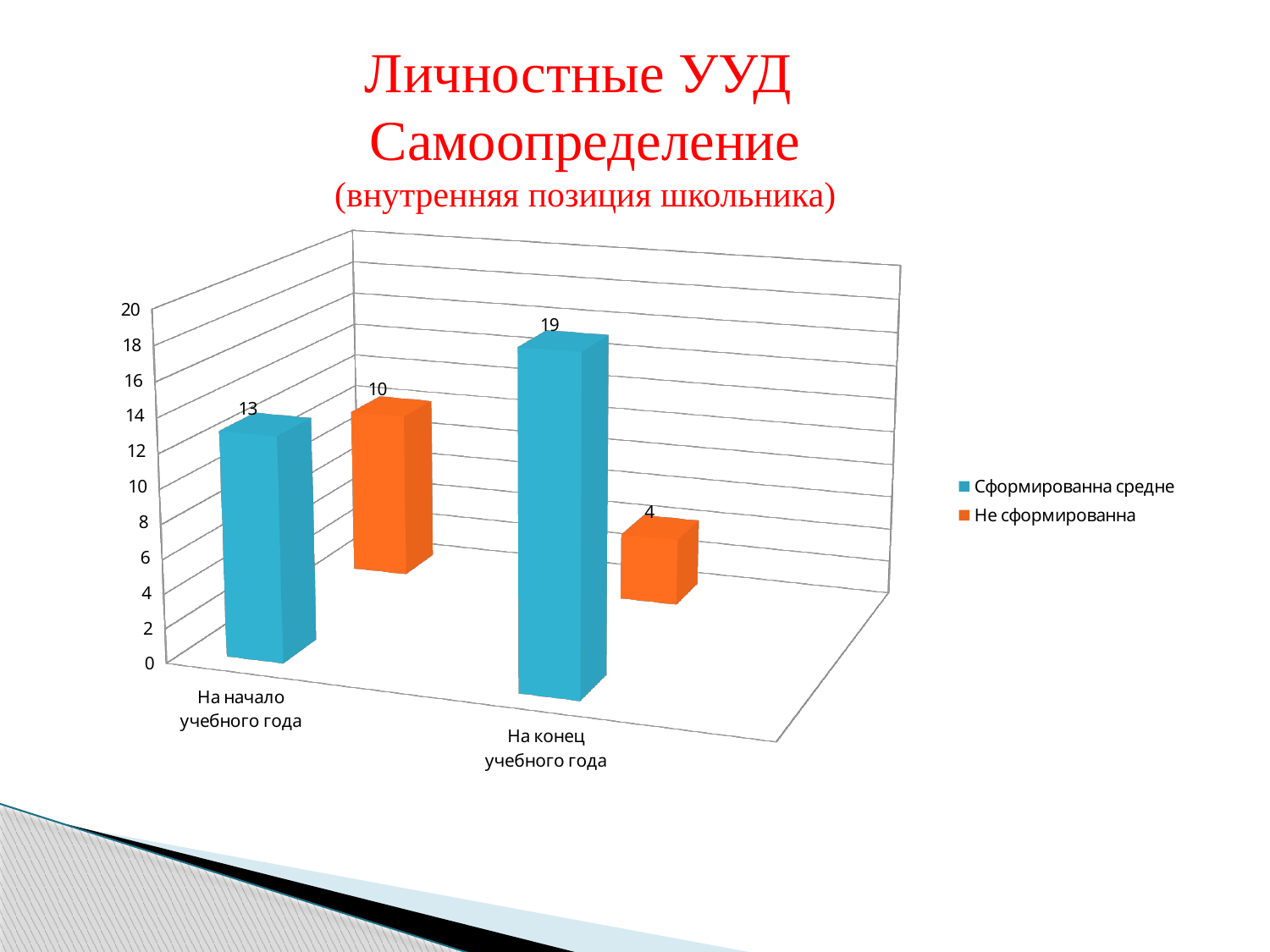
Does the "Не сформированна" series rise or fall from the start to the end of the school year? Fall How many series does the legend list? 2 Which category has the lowest value for "Не сформированна"? На конец учебного года What is the value for "Не сформированна" at "На конец учебного года"? 4 How many categories are shown on the x axis? 2 Which category has the highest value for "Сформированна средне"? На конец учебного года What is the value for "Не сформированна" at "На начало учебного года"? 10 What is the value for "Сформированна средне" at "На конец учебного года"? 19 Which is larger at "На начало учебного года": "Сформированна средне" or "Не сформированна"? Сформированна средне What is the value for "Сформированна средне" at "На начало учебного года"? 13 What is the difference between the "Сформированна средне" values at the end and at the start of the school year? 6 What kind of chart is shown on the slide? Bar chart